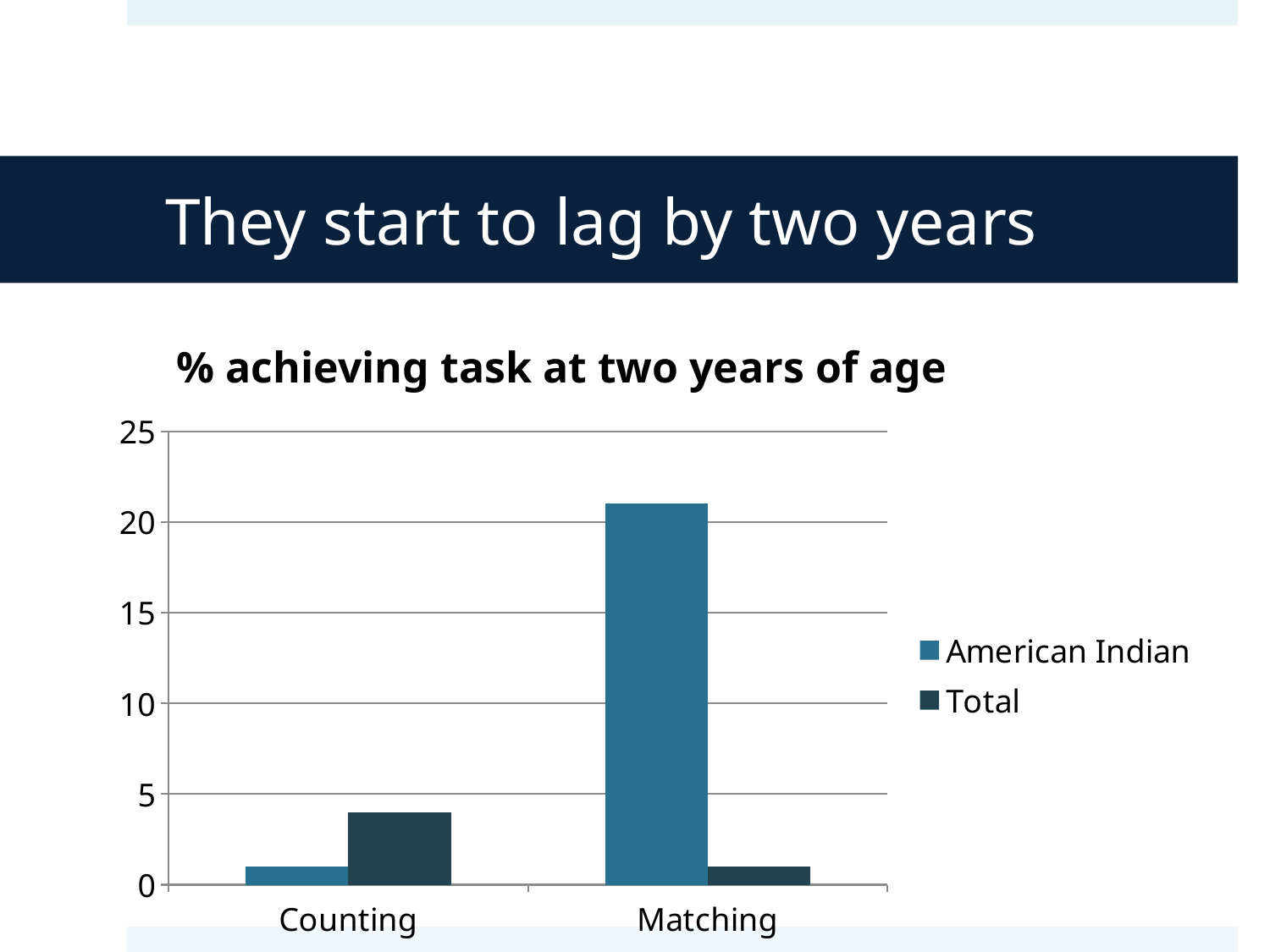
Is the Total value for Matching greater or less than 5? less Is the Total value for Counting greater or less than 5? less Is the American Indian value for Matching greater or less than 15? greater What kind of chart is shown on the slide? bar chart For Matching, which series has the larger value, American Indian or Total? American Indian How many series does the legend list? 2 For Counting, which series has the larger value, American Indian or Total? Total Which category has the higher Total value, Counting or Matching? Counting What is the title of the chart? % achieving task at two years of age Which series is shown in the darker colour in the legend? Total How many categories are shown on the x axis? 2 Which category has the higher American Indian value, Counting or Matching? Matching